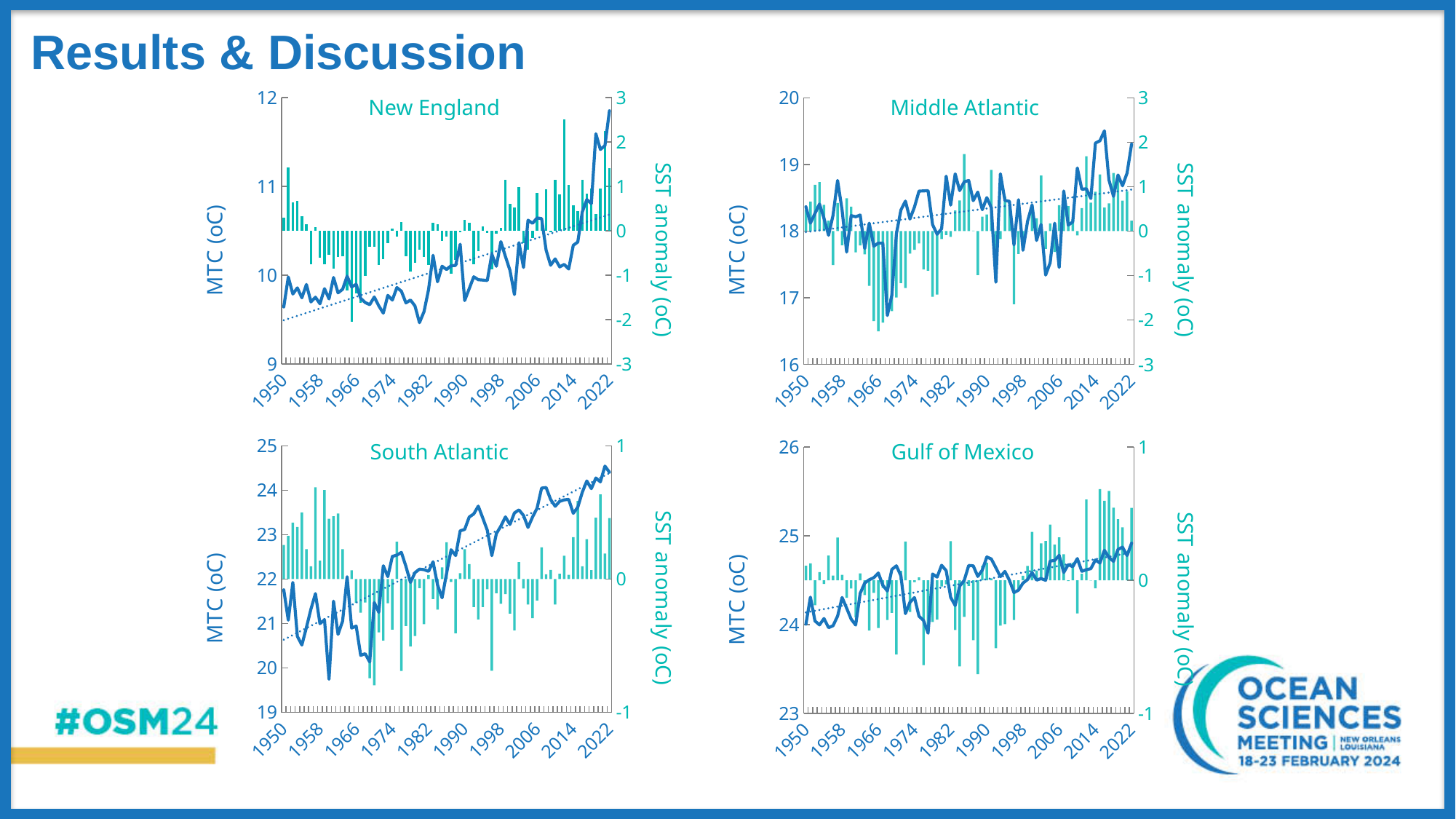
How many charts are shown on the slide? 4 In the New England chart, does the MTC line generally rise or fall from 1950 to 2022? rise In the New England chart, is the MTC value at 2022 greater or less than 11? greater In the Middle Atlantic chart, is the MTC value at 1950 greater or less than 19? less In the South Atlantic chart, does the MTC line generally rise or fall from 1950 to 2022? rise In the New England chart, is the MTC value at 2022 higher or lower than at 1950? higher What is the title of the top-right chart? Middle Atlantic In the Gulf of Mexico chart, what is the label of the right y-axis? SST anomaly (oC) What kind of chart is the New England chart? combined line and bar chart In the Middle Atlantic chart, is the lowest SST anomaly bar greater or less than -1? less